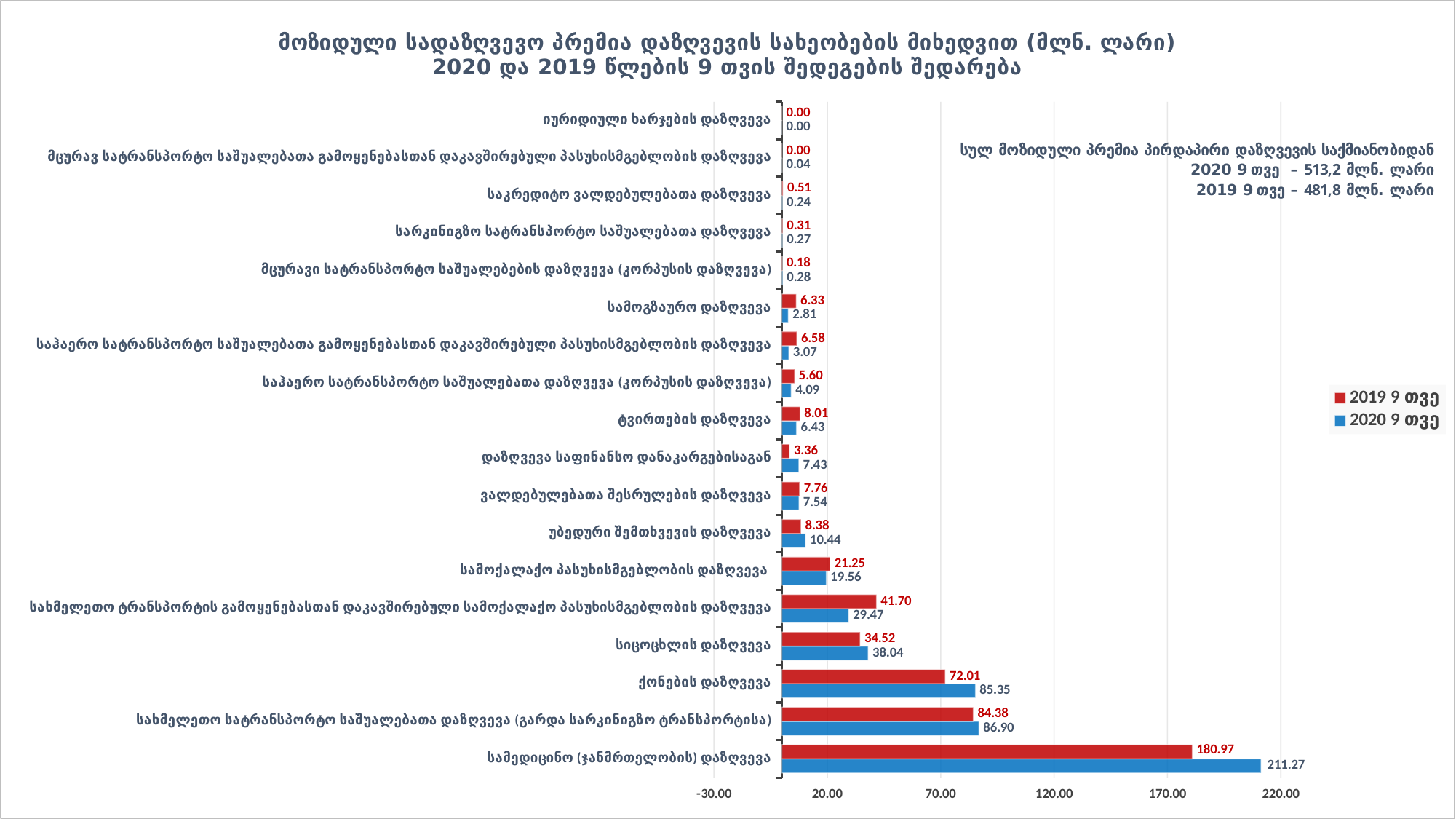
What is the difference between the 2019 9 თვე and 2020 9 თვე values for სახმელეთო ტრანსპორტის გამოყენებასთან დაკავშირებული სამოქალაქო პასუხისმგებლობის დაზღვევა? 12.23 What is the 2020 9 თვე value for სიცოცხლის დაზღვევა? 38.04 What kind of chart is shown on the slide? bar chart For დაზღვევა საფინანსო დანაკარგებისაგან, which is larger: the 2019 9 თვე value or the 2020 9 თვე value? 2020 9 თვე Which category has the highest 2019 9 თვე value? სამედიცინო (ჯანმრთელობის) დაზღვევა For სამოგზაურო დაზღვევა, which is larger: the 2019 9 თვე value or the 2020 9 თვე value? 2019 9 თვე What is the 2019 9 თვე value for ქონების დაზღვევა? 72.01 How many series does the legend list? 2 What is the 2020 9 თვე value for სამედიცინო (ჯანმრთელობის) დაზღვევა? 211.27 How many insurance categories are plotted on the chart? 18 Which colour represents the 2020 9 თვე series in the legend? blue What is the difference between the 2020 9 თვე and 2019 9 თვე values for სამედიცინო (ჯანმრთელობის) დაზღვევა? 30.30